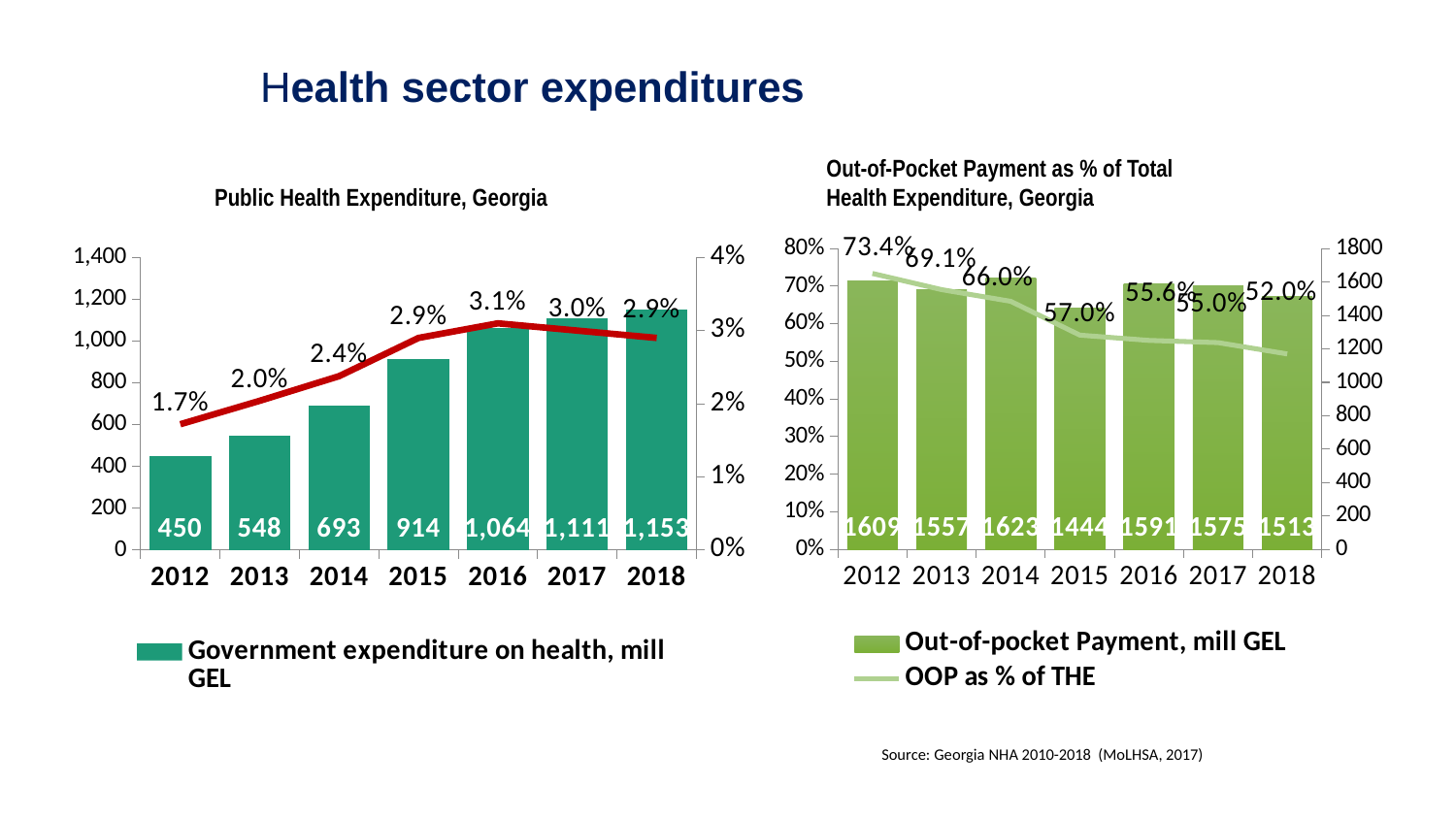
How many series does the legend of the Out-of-Pocket Payment chart list? 2 In the Public Health Expenditure, Georgia chart, what percentage value does the line show for 2016? 3.1% In the Public Health Expenditure, Georgia chart, by how much did government expenditure on health increase from 2012 to 2018? 703 In the Out-of-Pocket Payment chart, does OOP as % of THE rise or fall from 2012 to 2018? fall In the Out-of-Pocket Payment chart, what was the out-of-pocket payment in mill GEL in 2015? 1444 In the Out-of-Pocket Payment chart, what was OOP as % of THE in 2018? 52.0% How many years are shown on the x axis of the Public Health Expenditure, Georgia chart? 7 In the Out-of-Pocket Payment chart, which year has the lowest out-of-pocket payment in mill GEL? 2015 In the Public Health Expenditure, Georgia chart, do the bar values rise or fall from 2012 to 2018? rise In the Out-of-Pocket Payment chart, which is larger: the out-of-pocket payment in 2014 or in 2015? 2014 In the Public Health Expenditure, Georgia chart, what was government expenditure on health in 2015? 914 In the Public Health Expenditure, Georgia chart, which year has the highest government expenditure on health? 2018